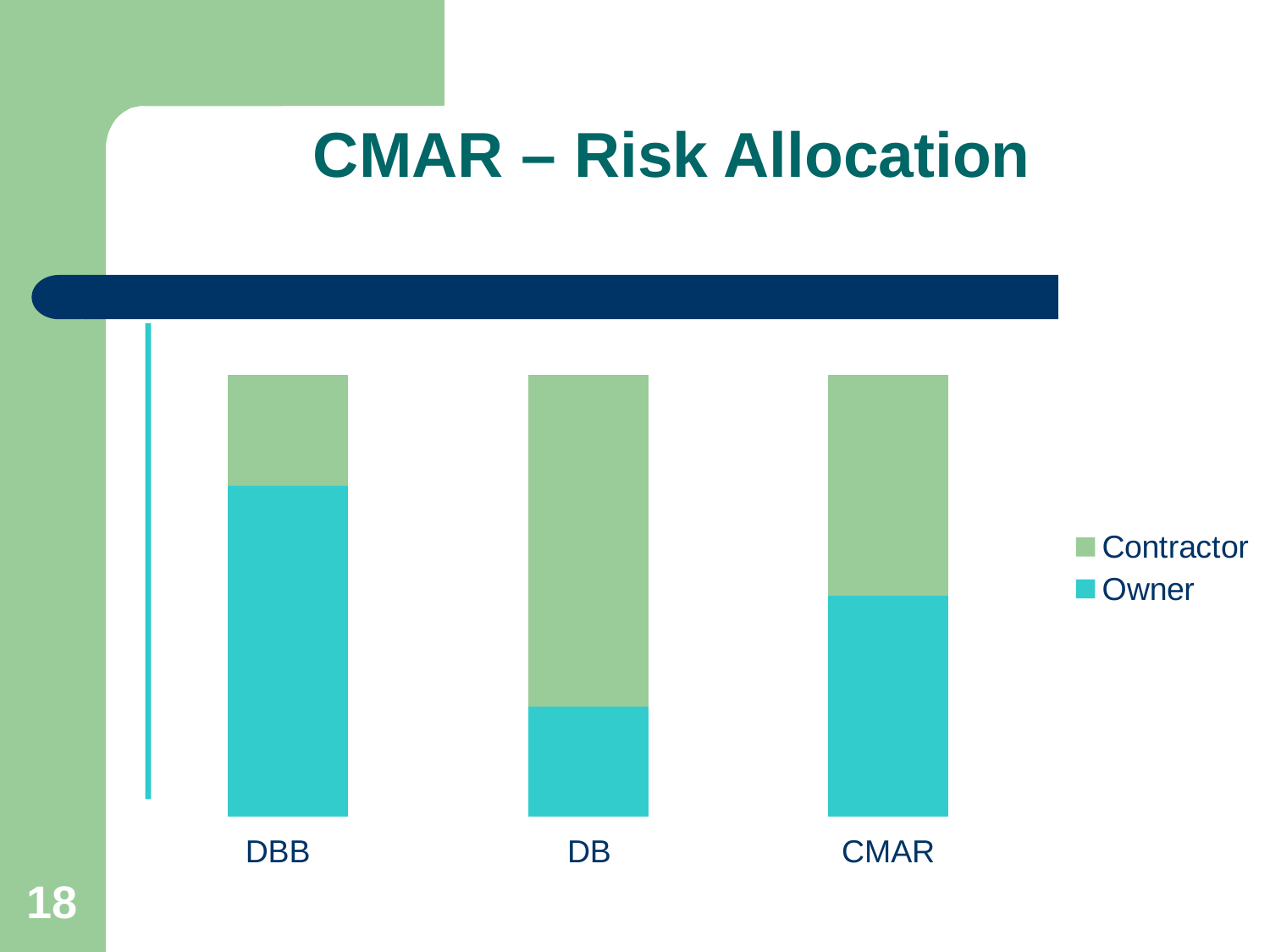
Which category has the largest Owner portion? DBB Which category has the smallest Owner portion? DB Is the Owner portion larger for DBB or for DB? DBB What is the title of the slide containing the chart? CMAR – Risk Allocation Which category has the largest Contractor portion? DB Which category has the smallest Contractor portion? DBB How many series does the chart's legend list? 2 How many categories are shown along the x axis of the chart? 3 In the DBB bar, which is larger, the Owner portion or the Contractor portion? Owner In the DB bar, which is larger, the Contractor portion or the Owner portion? Contractor What kind of chart is shown on the slide? stacked bar chart What are the names of the series listed in the legend? Contractor and Owner